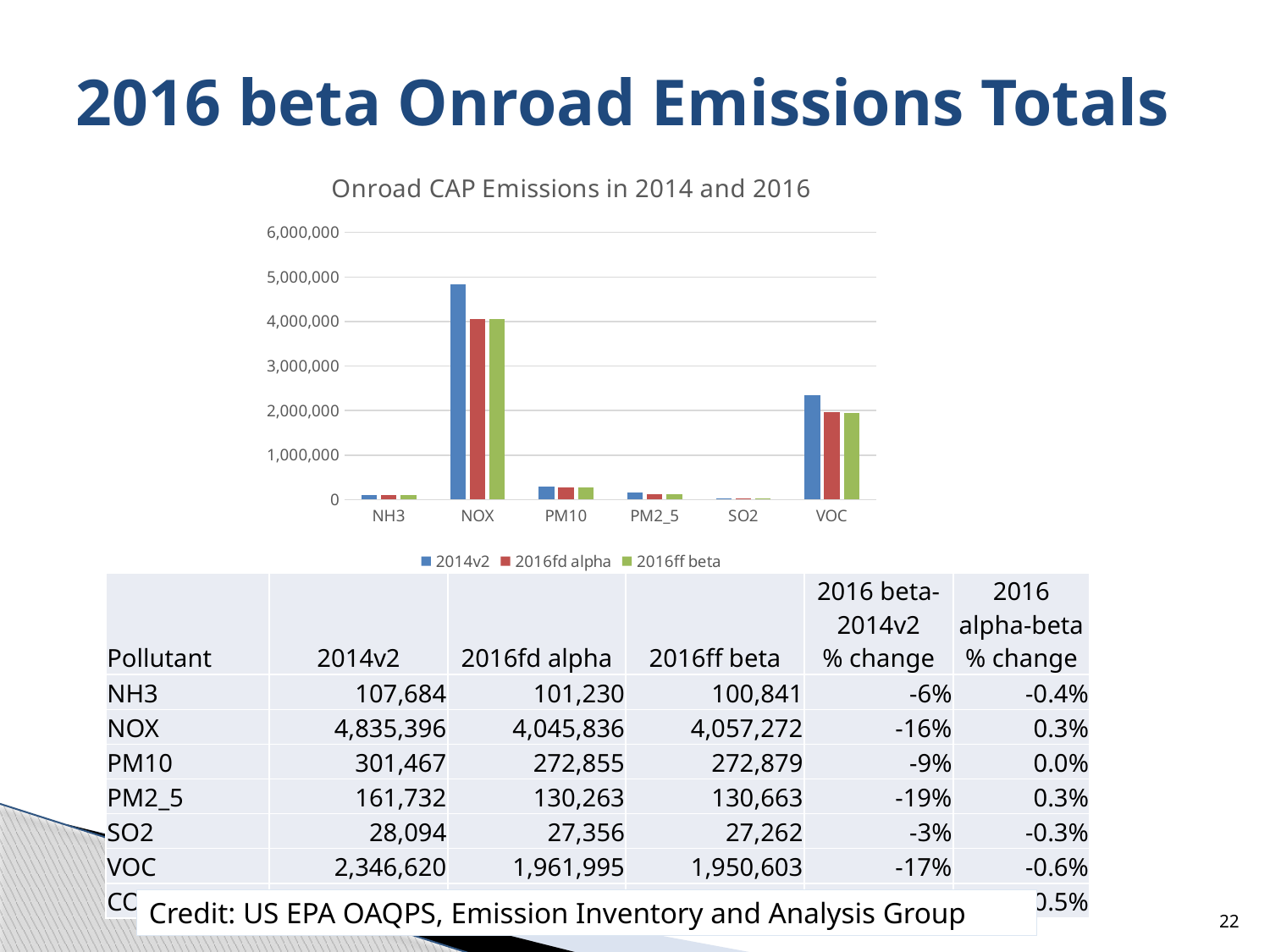
Which is larger for 2014v2: NOX or VOC? NOX For VOC, which series is larger: 2014v2 or 2016ff beta? 2014v2 How many series does the chart legend list? 3 Is the 2016ff beta value for VOC greater or less than 2,000,000? less What type of chart is shown on the slide? bar chart Using the values printed in the table, what is the difference between the 2014v2 and 2016ff beta values for VOC? 396,017 Is the 2014v2 value for NOX greater or less than 4,000,000? greater Which pollutant has the highest emissions in the chart? NOX What is the title of the chart? Onroad CAP Emissions in 2014 and 2016 What is the 2014v2 value for NOX, as printed in the table below the chart? 4,835,396 How many pollutant categories are shown on the x axis of the chart? 6 Which pollutant has the lowest emissions in the chart? SO2